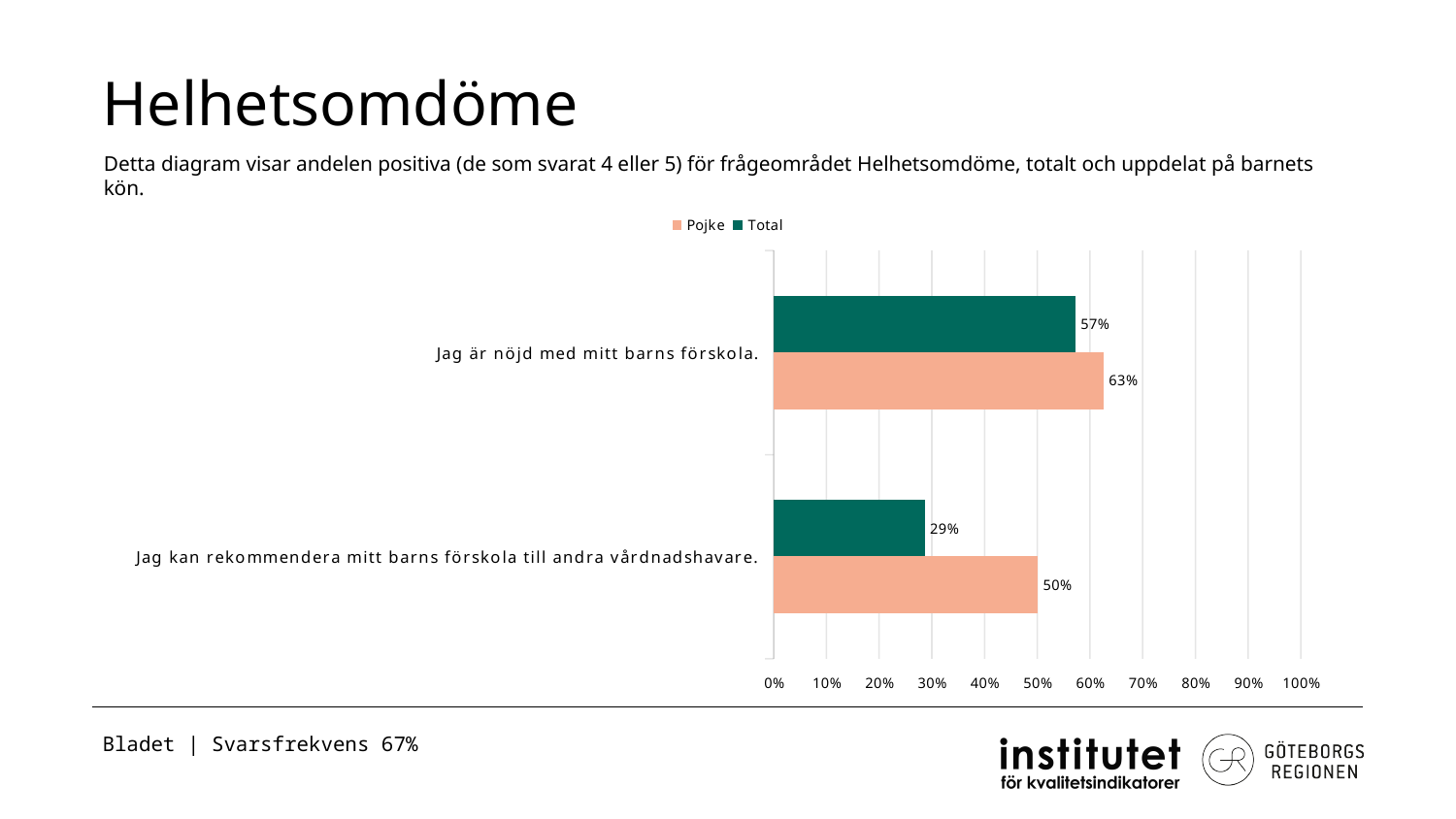
How many series does the legend list? 2 What is the Pojke value for "Jag kan rekommendera mitt barns förskola till andra vårdnadshavare."? 50% What is the Total value for "Jag kan rekommendera mitt barns förskola till andra vårdnadshavare."? 29% Which statement has the highest Pojke value? Jag är nöjd med mitt barns förskola. What is the difference between the Pojke and Total values for "Jag kan rekommendera mitt barns förskola till andra vårdnadshavare."? 21 percentage points Which statement has the lowest Total value? Jag kan rekommendera mitt barns förskola till andra vårdnadshavare. What kind of chart is shown on the slide? Bar chart What is the Pojke value for "Jag är nöjd med mitt barns förskola."? 63% What is the Total value for "Jag är nöjd med mitt barns förskola."? 57% For "Jag är nöjd med mitt barns förskola.", which is larger, the Pojke value or the Total value? Pojke What is the difference between the Pojke and Total values for "Jag är nöjd med mitt barns förskola."? 6 percentage points How many statements (categories) are shown in the chart? 2